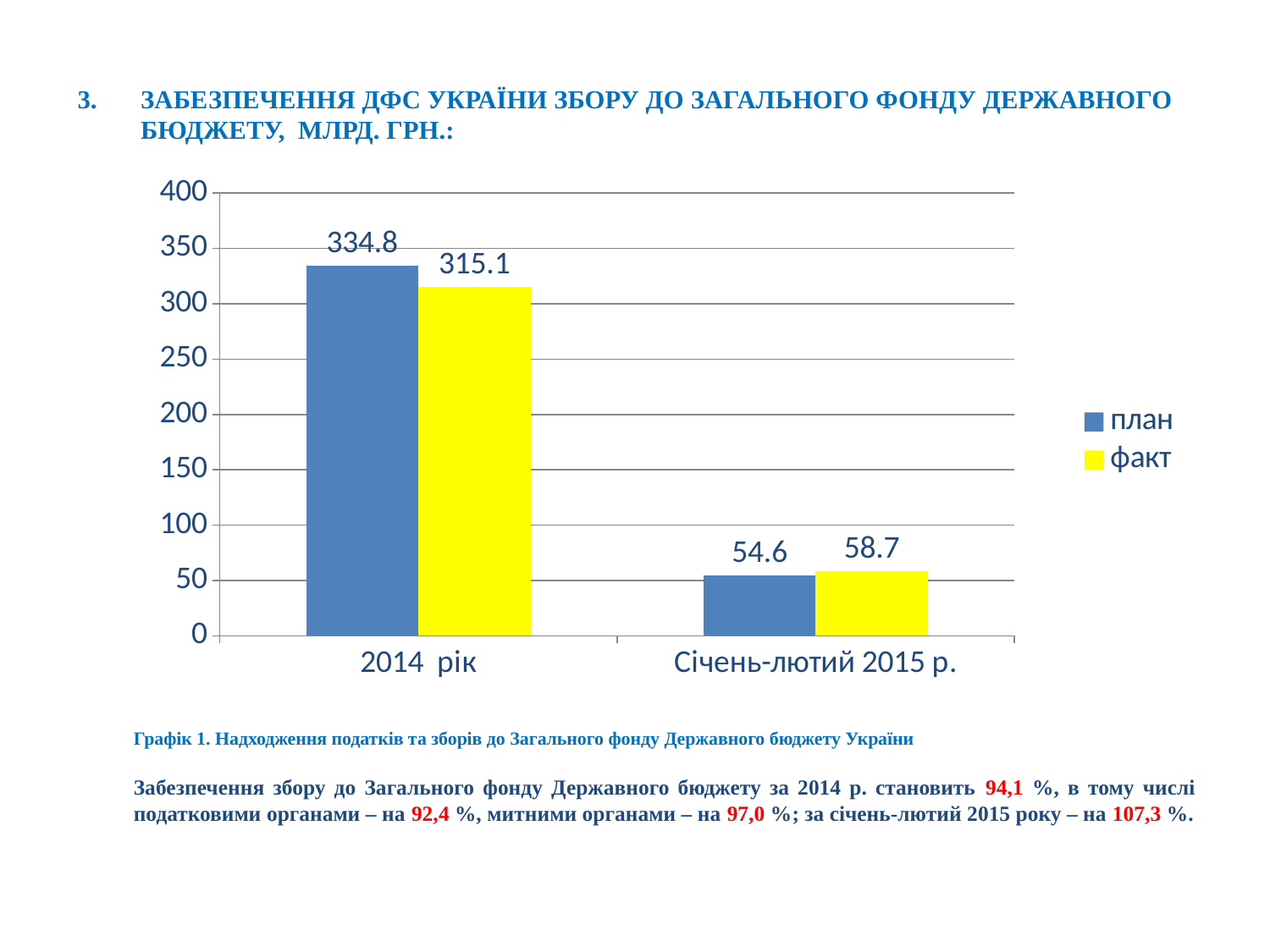
What is the 'план' value for '2014 рік'? 334.8 What is the 'план' value for 'Січень-лютий 2015 р.'? 54.6 What type of chart is shown on the slide? bar chart What is the difference between 'план' and 'факт' for '2014 рік'? 19.7 Which category has the highest 'план' value? 2014 рік For 'Січень-лютий 2015 р.', which is larger: 'план' or 'факт'? факт Which category has the lowest 'факт' value? Січень-лютий 2015 р. How many series does the legend list? 2 How many categories are shown on the x axis? 2 What is the 'факт' value for '2014 рік'? 315.1 What is the difference between 'факт' and 'план' for 'Січень-лютий 2015 р.'? 4.1 What is the 'факт' value for 'Січень-лютий 2015 р.'? 58.7